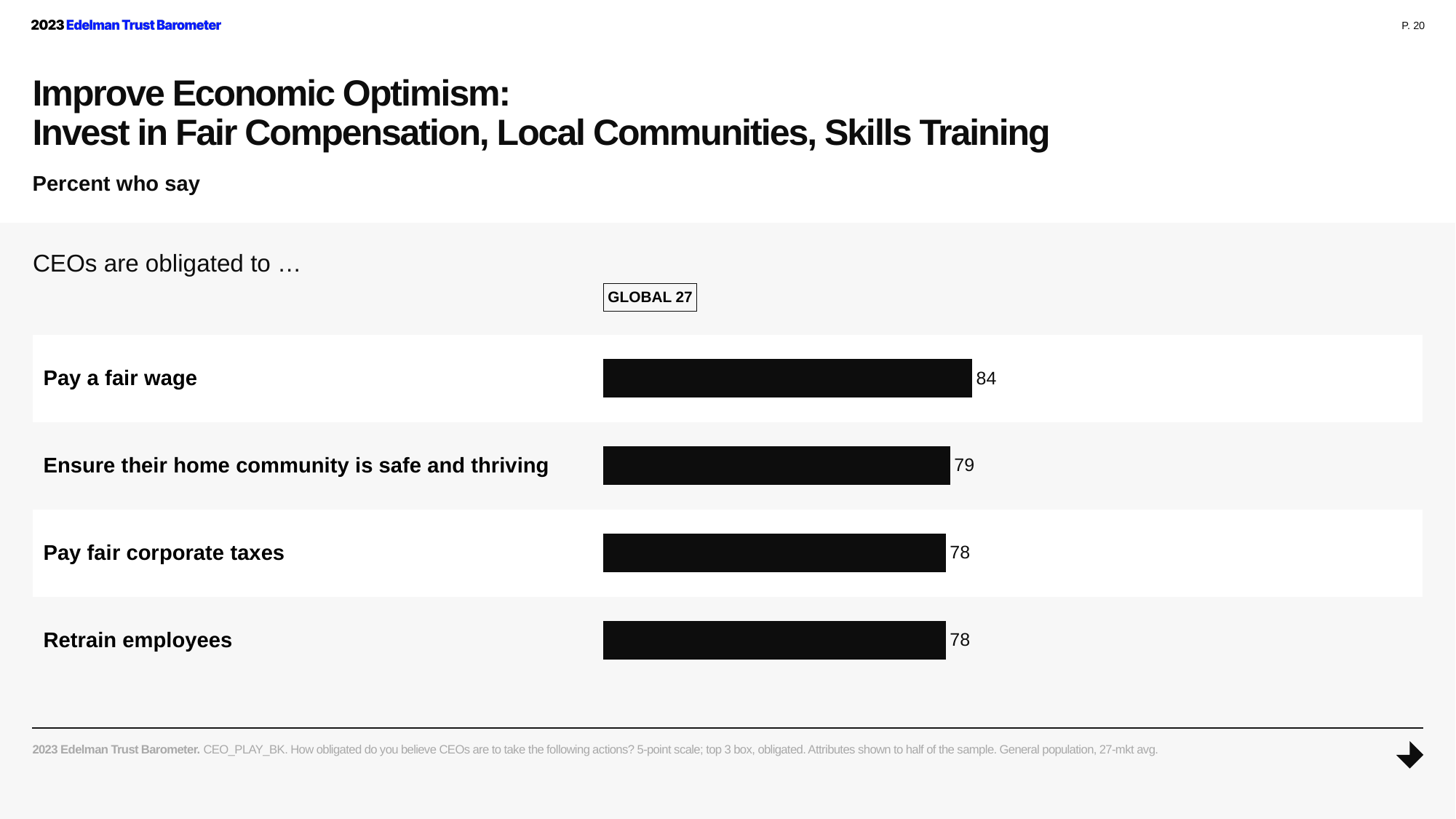
How many categories are shown in the chart? 4 What is the heading above the chart that the categories complete? CEOs are obligated to … What percent say CEOs are obligated to pay a fair wage? 84 What label appears in the box above the bars? GLOBAL 27 Which category has the highest value? Pay a fair wage What is the difference between the values for 'Pay a fair wage' and 'Ensure their home community is safe and thriving'? 5 What is the difference between the values for 'Pay a fair wage' and 'Retrain employees'? 6 What is the value for 'Retrain employees'? 78 What is the value for 'Pay fair corporate taxes'? 78 Which is larger: the value for 'Pay a fair wage' or the value for 'Pay fair corporate taxes'? Pay a fair wage What kind of chart is shown on the slide? Bar chart What is the value for 'Ensure their home community is safe and thriving'? 79